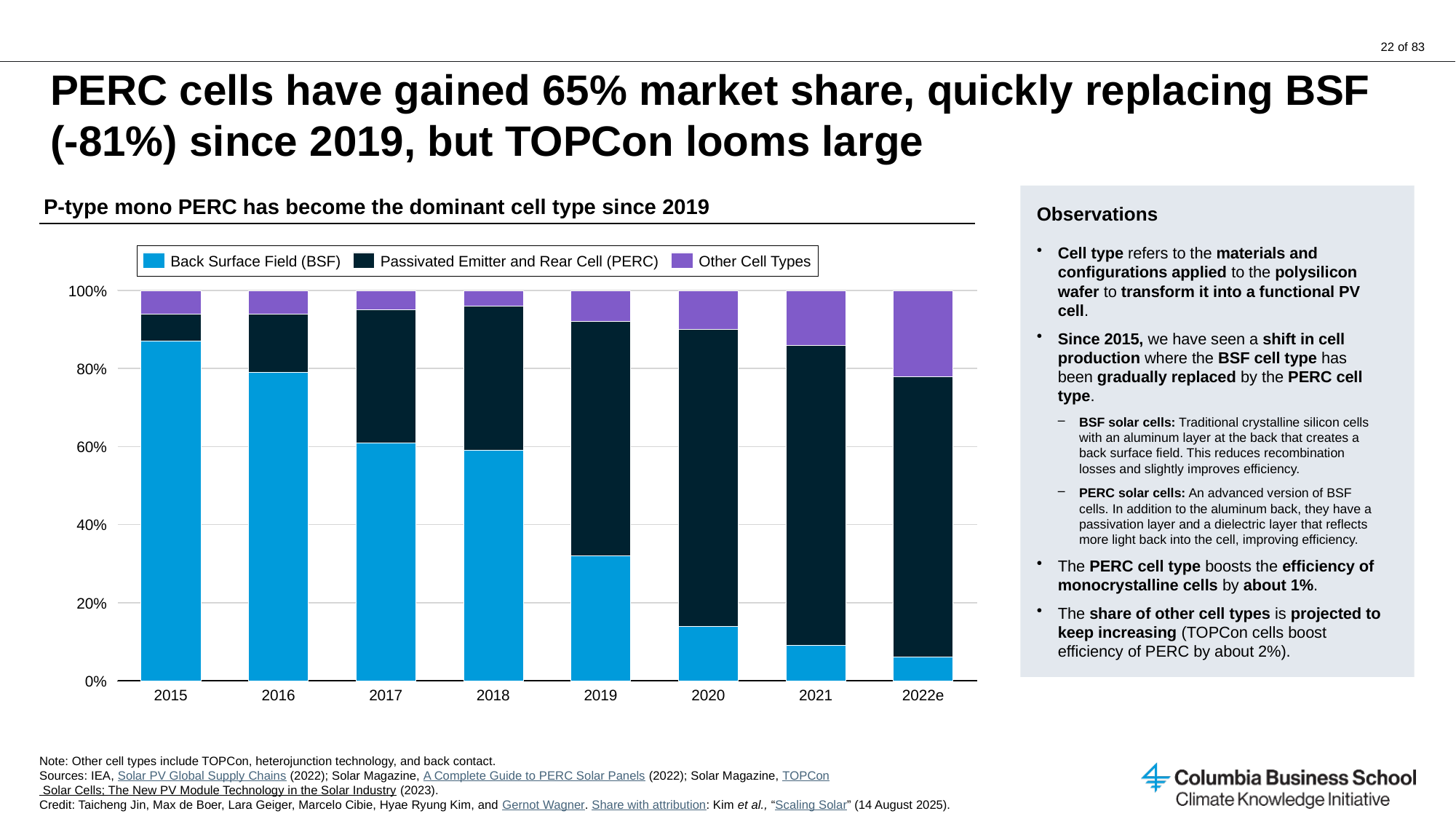
Which year has the largest Back Surface Field (BSF) share? 2015 What kind of chart is shown on the slide? Stacked bar chart Which year has the smallest Back Surface Field (BSF) share? 2022e How many series does the chart's legend list? 3 Which year has a larger Back Surface Field (BSF) share, 2016 or 2019? 2016 Is the Back Surface Field (BSF) share in 2015 greater or less than 80%? greater In which year is the Other Cell Types share the largest? 2022e Does the Back Surface Field (BSF) share rise or fall from 2015 to 2022e? fall Is the Back Surface Field (BSF) share in 2019 greater or less than 40%? less How many years are shown on the x axis of the chart? 8 What is the title of the chart? P-type mono PERC has become the dominant cell type since 2019 Is the Back Surface Field (BSF) share in 2020 greater or less than 20%? less